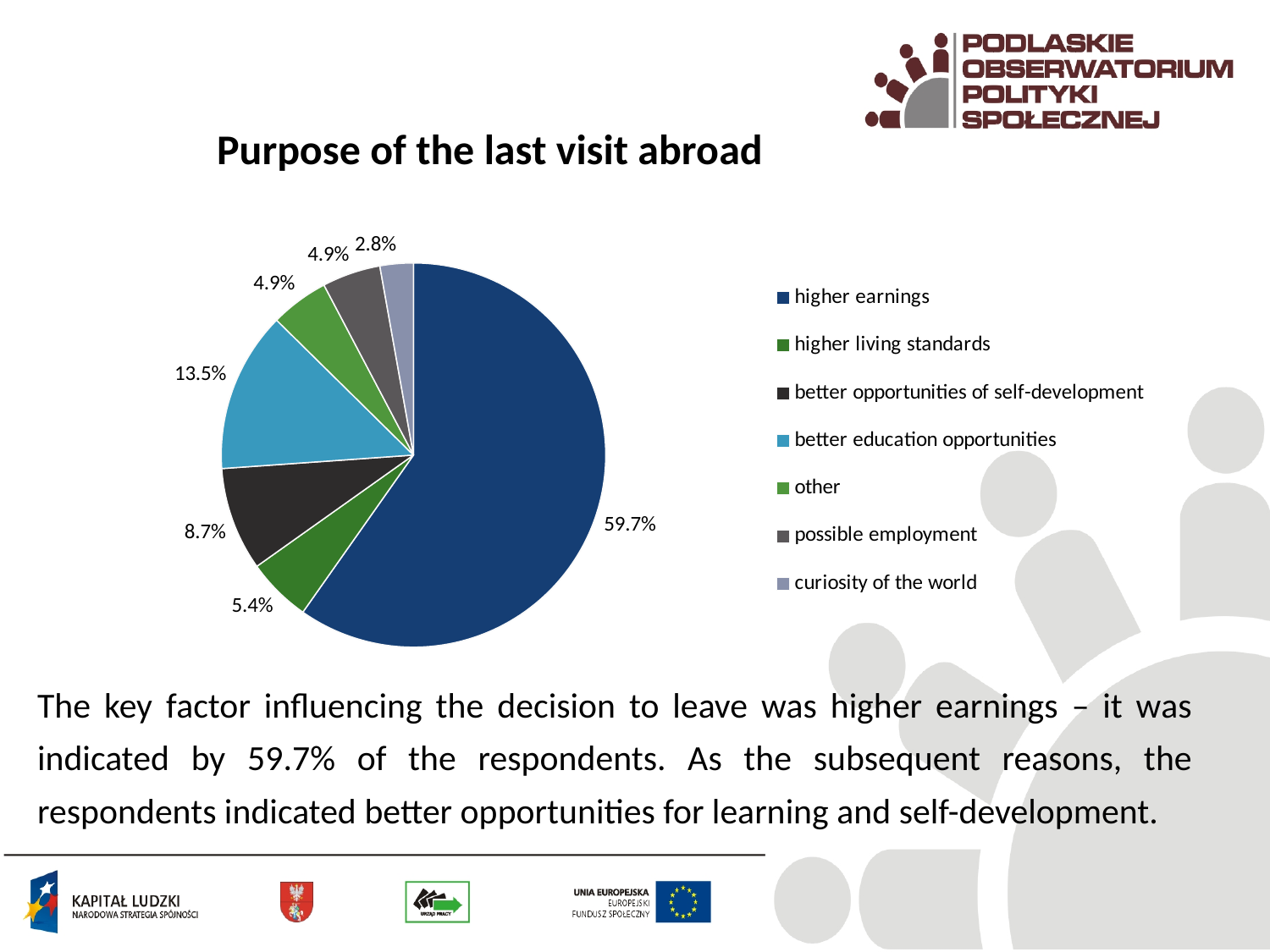
What share of respondents indicated higher earnings as the purpose of their last visit abroad? 59.7% Which purpose has the largest share of the pie? higher earnings What percentage is shown for better opportunities of self-development? 8.7% What percentage is shown for higher living standards? 5.4% Which is larger: the share for higher living standards or the share for better opportunities of self-development? better opportunities of self-development Which purpose has the smallest share of the pie? curiosity of the world What percentage is shown for better education opportunities? 13.5% What is the title of the chart? Purpose of the last visit abroad How many categories does the legend list? 7 What is the difference in percentage points between better education opportunities and better opportunities of self-development? 4.8 What percentage is shown for curiosity of the world? 2.8% What type of chart is shown on the slide? pie chart